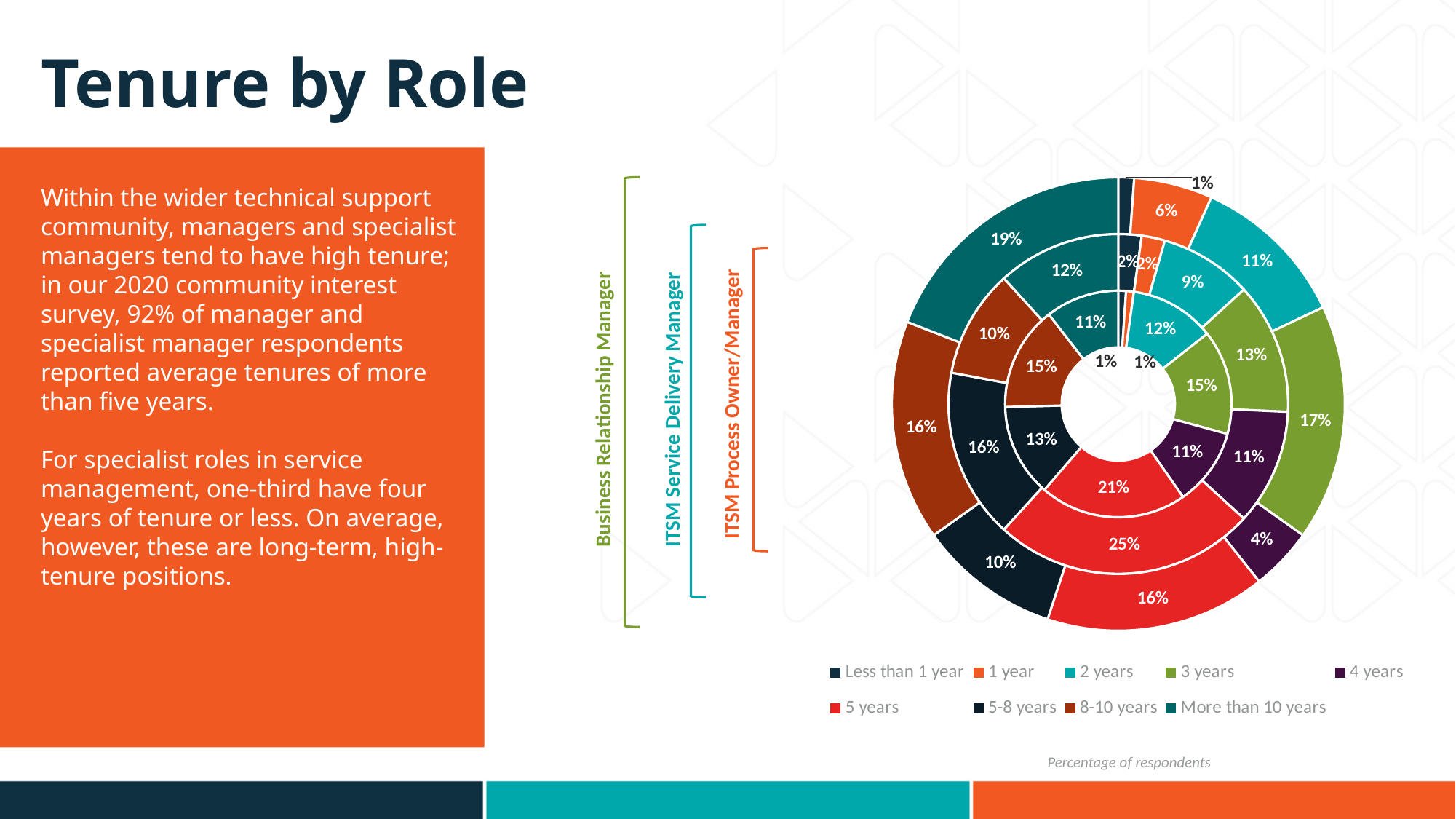
What percentage of ITSM Process Owner/Managers reported 2 years of tenure? 12% Which tenure category has the largest share for Business Relationship Managers? More than 10 years Which role is represented by the outer ring of the chart? Business Relationship Manager Which is larger for Business Relationship Managers: the 3 years share or the 4 years share? 3 years What percentage of Business Relationship Managers reported more than 10 years of tenure? 19% How many tenure categories does the legend list? 9 Which tenure category has the largest share for ITSM Process Owner/Managers? 5 years What is the difference between the 5 years share for ITSM Service Delivery Managers and for Business Relationship Managers? 9% What kind of chart is shown on the slide? Doughnut chart What is the combined share of ITSM Service Delivery Managers with less than 1 year and 1 year of tenure? 4% What percentage of ITSM Service Delivery Managers reported 5 years of tenure? 25% What percentage of Business Relationship Managers reported 4 years of tenure? 4%